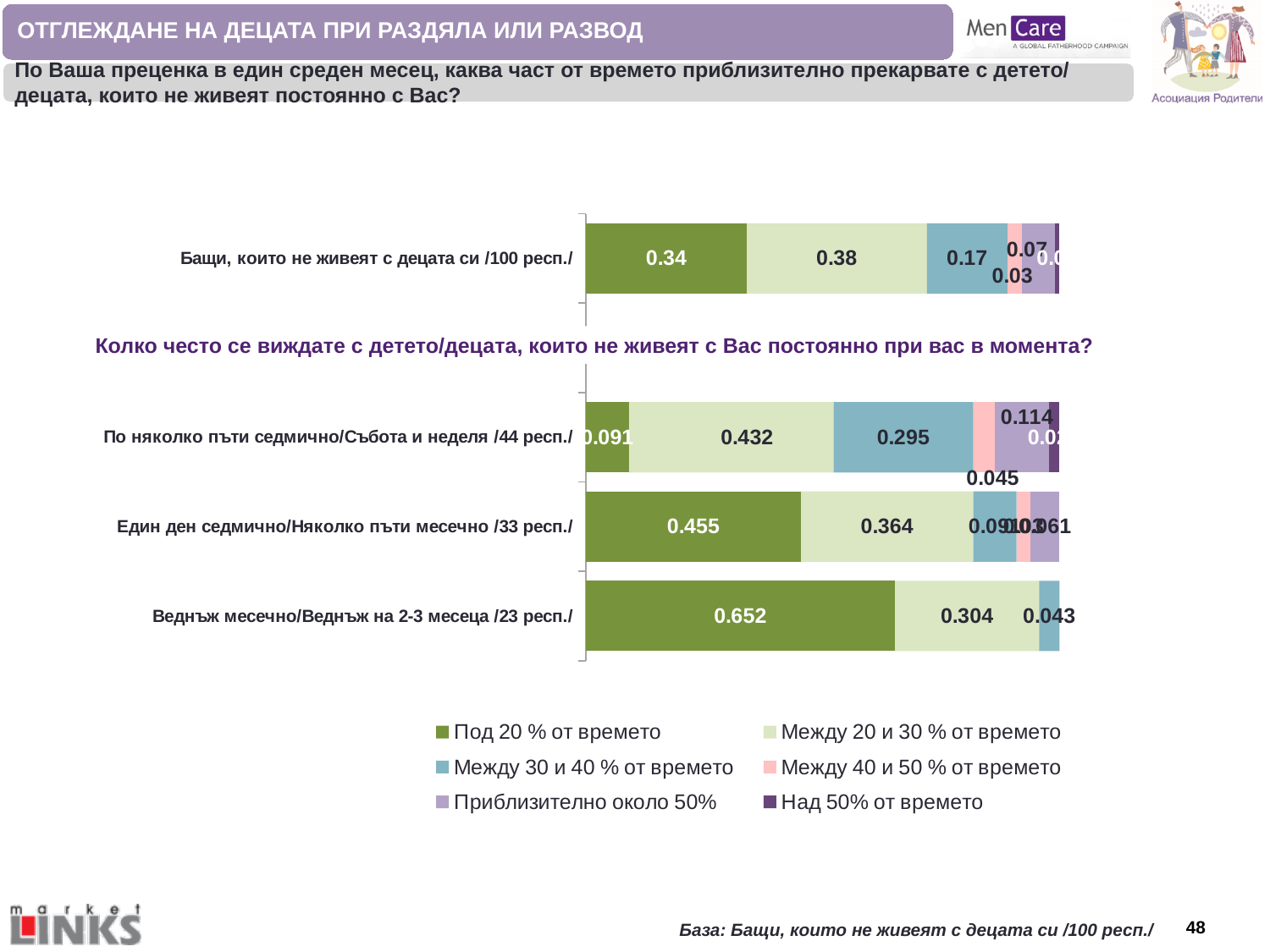
In the top chart, what is the difference between the 'Между 20 и 30 % от времето' value and the 'Под 20 % от времето' value? 0.04 In the top chart, what is the value for 'Между 30 и 40 % от времето'? 0.17 In the top chart, which series has the largest segment in the bar? Между 20 и 30 % от времето In the bottom chart, what is the difference between the 'Под 20 % от времето' values for 'Веднъж месечно/Веднъж на 2-3 месеца' and 'Един ден седмично/Няколко пъти месечно'? 0.197 In the bottom chart, what is the value for 'Между 20 и 30 % от времето' for 'По няколко пъти седмично/Събота и неделя /44 респ./'? 0.432 In the bottom chart, which category has the highest value for 'Под 20 % от времето'? Веднъж месечно/Веднъж на 2-3 месеца /23 респ./ In the bottom chart, which is larger for 'Между 30 и 40 % от времето': 'По няколко пъти седмично/Събота и неделя' or 'Веднъж месечно/Веднъж на 2-3 месеца'? По няколко пъти седмично/Събота и неделя In the top chart, what is the value for 'Под 20 % от времето' for 'Бащи, които не живеят с децата си /100 респ./'? 0.34 In the bottom chart, what is the value for 'Под 20 % от времето' for 'Веднъж месечно/Веднъж на 2-3 месеца /23 респ./'? 0.652 In the bottom chart, what is the value for 'Под 20 % от времето' for 'Един ден седмично/Няколко пъти месечно /33 респ./'? 0.455 How many series does the legend list? 6 In the top chart, what is the value for 'Между 20 и 30 % от времето'? 0.38